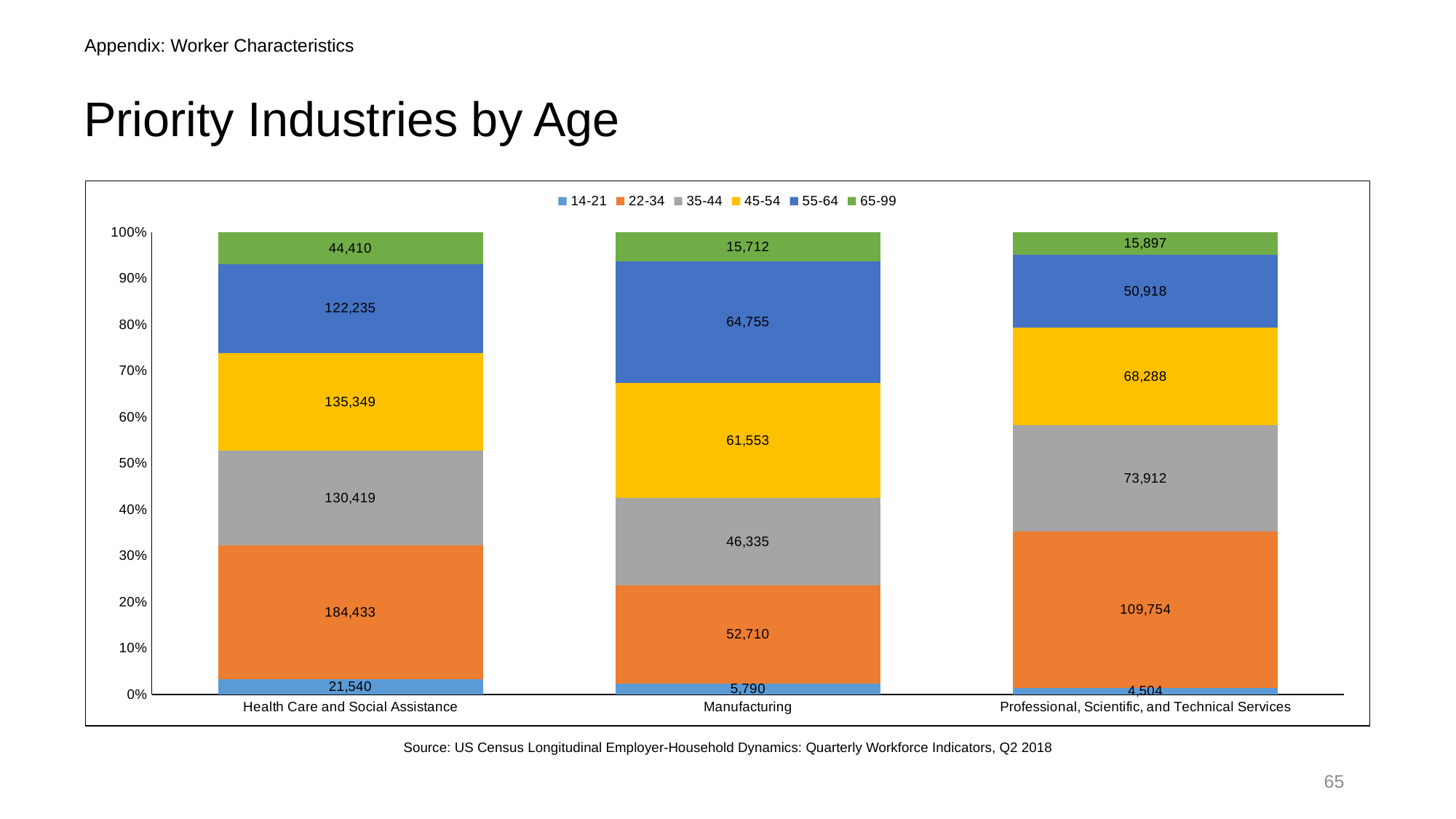
What is the value for the 35-44 age group in Professional, Scientific, and Technical Services? 73,912 Which is larger: the 55-64 value for Manufacturing or the 55-64 value for Professional, Scientific, and Technical Services? Manufacturing What is the title of the chart? Priority Industries by Age What is the difference between the 22-34 values for Health Care and Social Assistance and Professional, Scientific, and Technical Services? 74,679 Which industry has the highest value for the 22-34 age group? Health Care and Social Assistance What is the value for the 45-54 age group in Manufacturing? 61,553 What kind of chart is shown on the slide? Stacked bar chart What is the total of all age groups for Manufacturing? 246,855 How many industries are shown on the x axis? 3 Which industry has the lowest value for the 14-21 age group? Professional, Scientific, and Technical Services What is the value for the 22-34 age group in Health Care and Social Assistance? 184,433 How many age groups does the legend list? 6